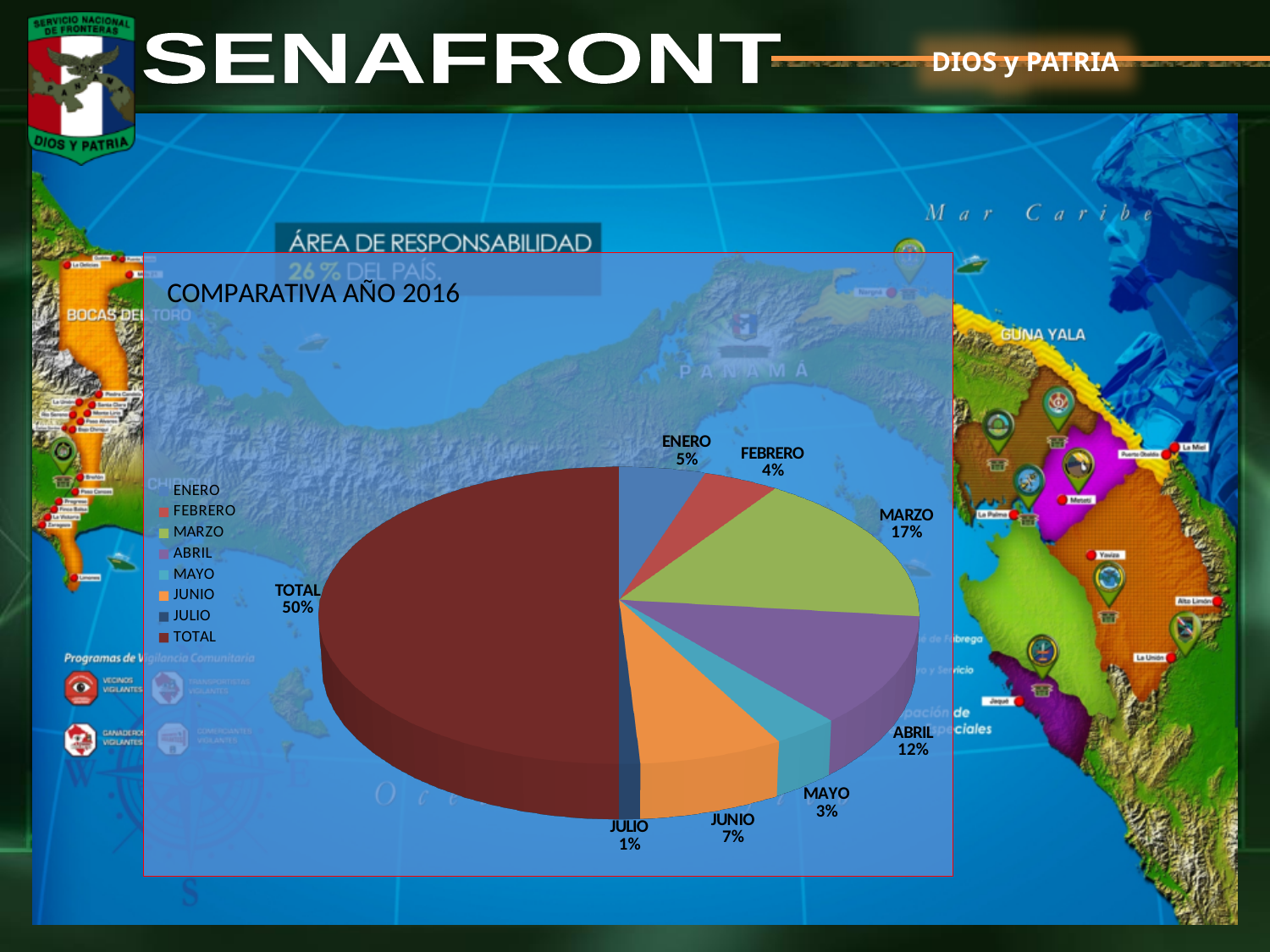
Which slice has the largest share? TOTAL Which has a larger share, ENERO or FEBRERO? ENERO What is the title of the chart? COMPARATIVA AÑO 2016 What is the difference in percentage points between MARZO and ABRIL? 5 How many entries does the legend list? 8 What percentage share does JULIO have? 1% What is the combined share of JUNIO and MAYO? 10% What kind of chart is shown on the slide? pie chart What percentage share does MARZO have? 17% What percentage share does ABRIL have? 12% What percentage share does TOTAL have? 50% Which slice has the smallest share? JULIO